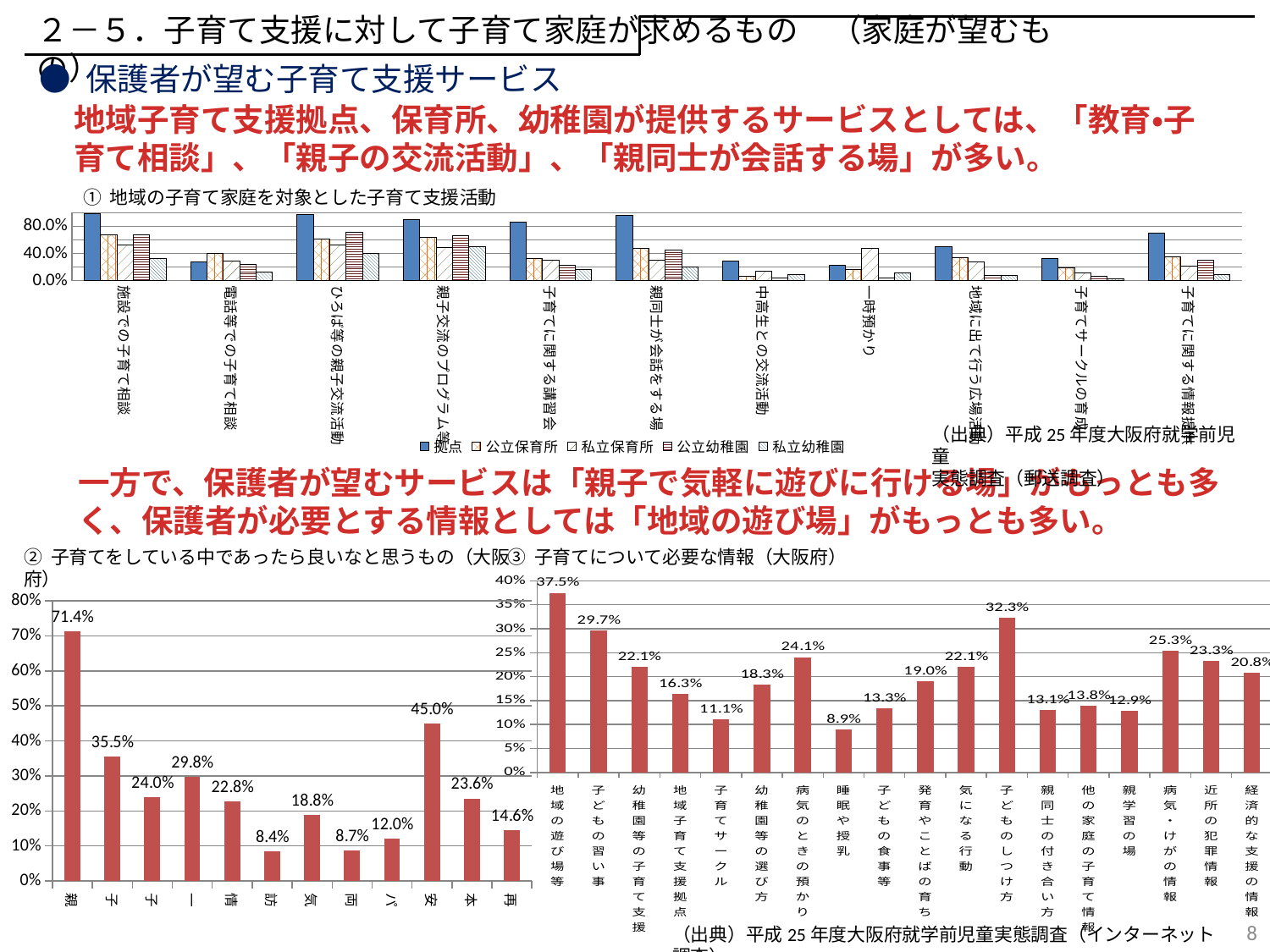
In chart ③ 子育てについて必要な情報（大阪府）, what is the difference between 地域の遊び場等 and 子どもの習い事? 7.8% In chart ③ 子育てについて必要な情報（大阪府）, which category has the lowest value? 睡眠や授乳 In chart ② 子育てをしている中であったら良いなと思うもの（大阪府）, how many bars are plotted? 12 In chart ③ 子育てについて必要な情報（大阪府）, how many categories are plotted? 18 In chart ② 子育てをしている中であったら良いなと思うもの（大阪府）, what is the highest value shown? 71.4% In chart ③ 子育てについて必要な情報（大阪府）, which category has the highest value? 地域の遊び場等 What kind of chart is chart ① 地域の子育て家庭を対象とした子育て支援活動? bar chart In chart ③ 子育てについて必要な情報（大阪府）, what is the value for 地域の遊び場等? 37.5% In chart ① 地域の子育て家庭を対象とした子育て支援活動, how many series does the legend list? 5 In chart ③ 子育てについて必要な情報（大阪府）, which is larger: 病気のときの預かり or 近所の犯罪情報? 病気のときの預かり In chart ③ 子育てについて必要な情報（大阪府）, what is the value for 子どものしつけ方? 32.3% In chart ① 地域の子育て家庭を対象とした子育て支援活動, is the value of 拠点 for 電話等での子育て相談 greater or less than 40.0%? less